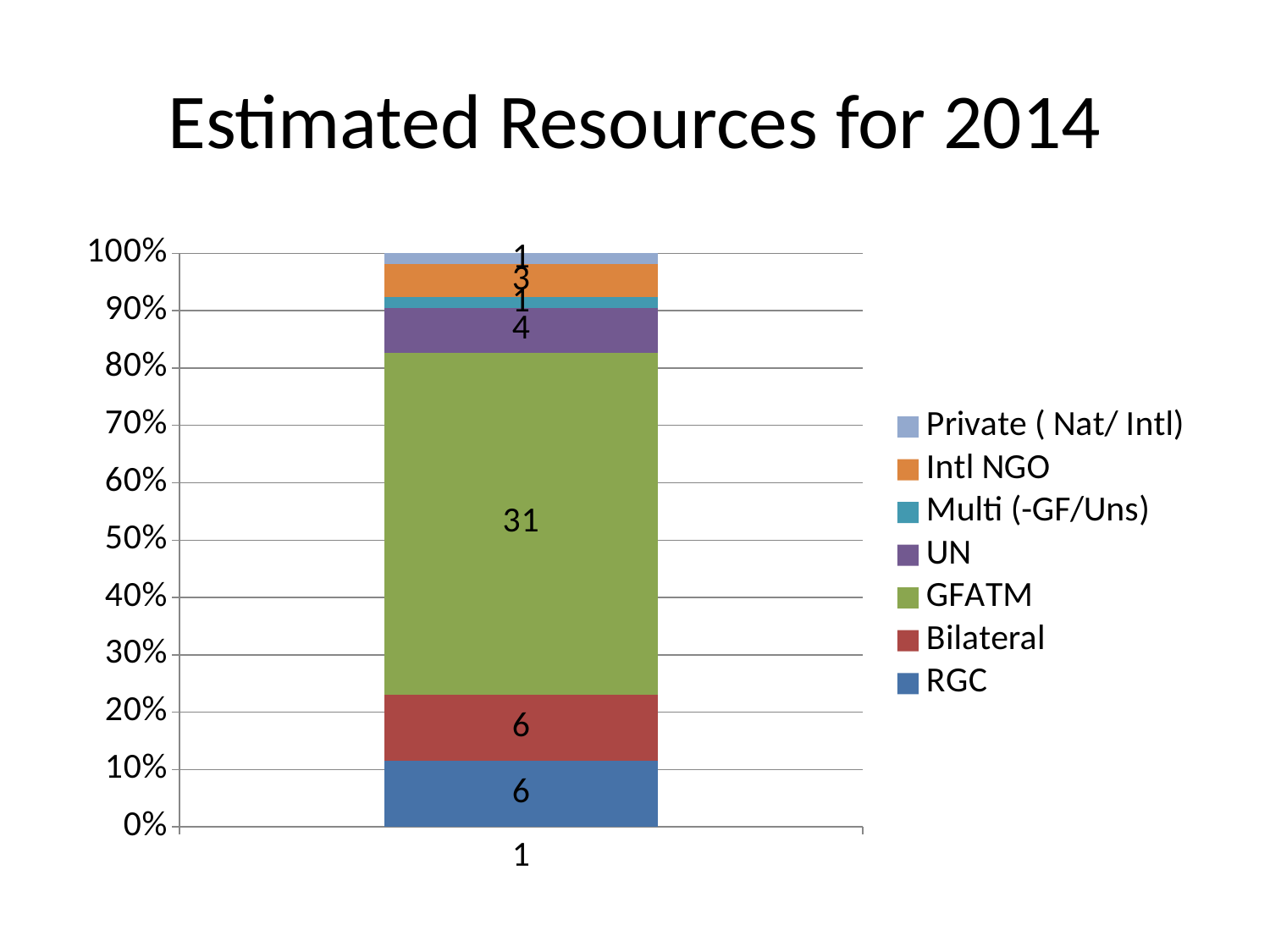
What is the value of the Intl NGO segment in the stacked bar? 3 How many series does the legend list? 7 Which is larger, the UN value or the Intl NGO value? UN What is the value of the UN segment in the stacked bar? 4 What is the title of the chart? Estimated Resources for 2014 What kind of chart is shown on the slide? Stacked bar chart What is the value of the RGC segment in the stacked bar? 6 What is the total of all segments in the stacked bar? 52 What is the difference between the GFATM value and the Bilateral value? 25 What is the value of the GFATM segment in the stacked bar? 31 Which series is shown in green in the stacked bar? GFATM Which series has the largest segment in the stacked bar? GFATM